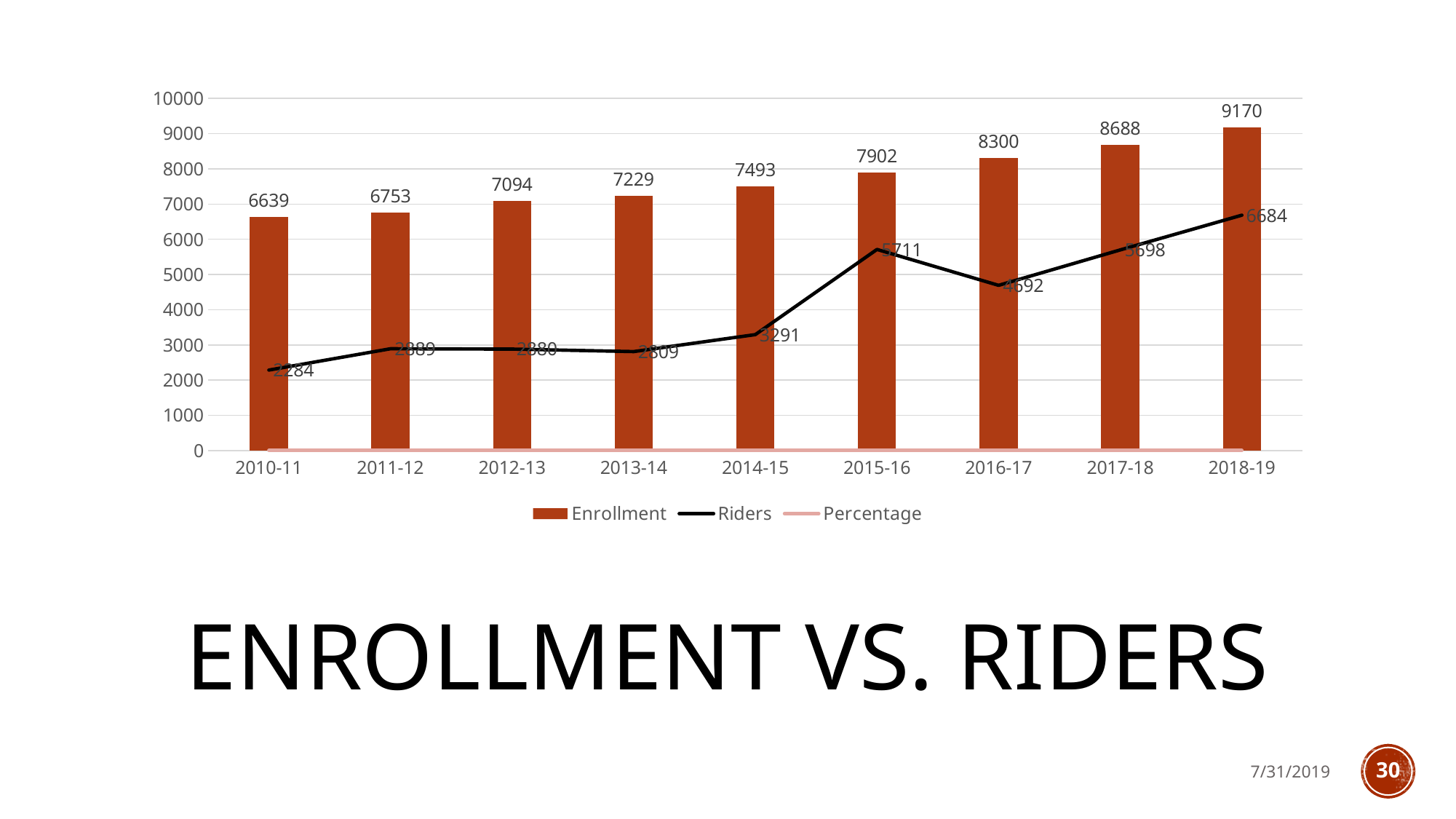
In 2018-19, what is the difference between Enrollment and Riders? 2486 How many school years are shown on the x axis? 9 What is the Riders value for 2018-19? 6684 Which year has the highest Enrollment? 2018-19 Which year has the lowest Enrollment? 2010-11 What kind of chart is shown on the slide? A combination bar and line chart Which year has more Riders, 2015-16 or 2016-17? 2015-16 How many series does the legend list? 3 What is the Riders value for 2015-16? 5711 Does Enrollment rise or fall from 2010-11 to 2018-19? Rises What is the difference between Enrollment in 2018-19 and Enrollment in 2010-11? 2531 What is the Enrollment value for 2018-19? 9170